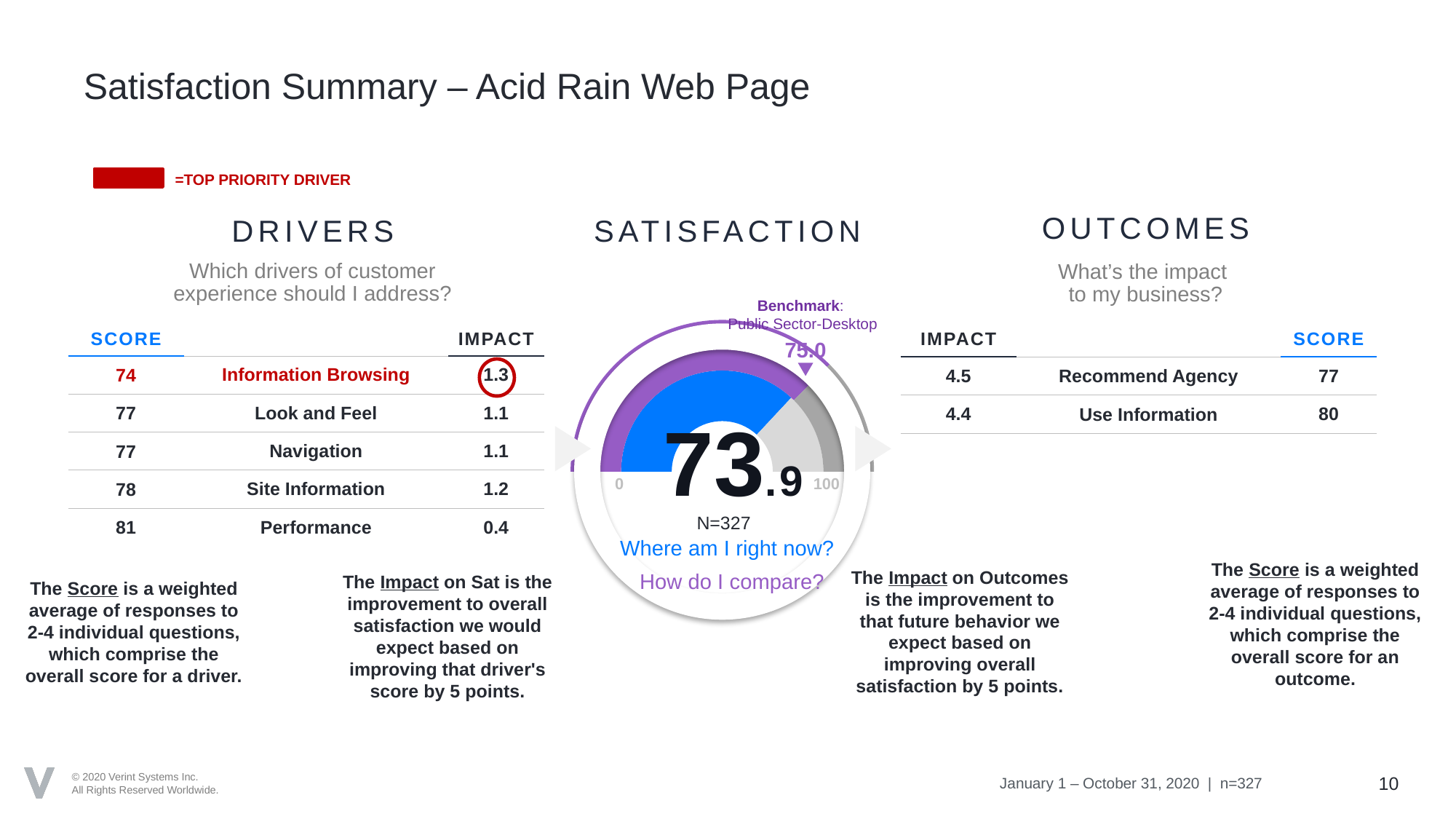
What is the benchmark value marked on the satisfaction gauge? 75.0 In the Drivers table, which driver has the lowest score? Information Browsing Is the satisfaction score on the gauge greater or less than 50? greater What satisfaction score does the gauge chart display? 73.9 What are the minimum and maximum values shown on the satisfaction gauge scale? 0 and 100 What is the sample size (N) shown below the satisfaction gauge? N=327 Which is larger on the satisfaction gauge: the score or the benchmark? the benchmark (75.0) What kind of chart is shown in the Satisfaction section of the slide? gauge chart By how much does the benchmark exceed the satisfaction score on the gauge? 1.1 In the Drivers table, which driver has the highest impact? Information Browsing Which benchmark group is the satisfaction gauge compared against? Public Sector-Desktop In the Outcomes table, what is the score for Use Information? 80